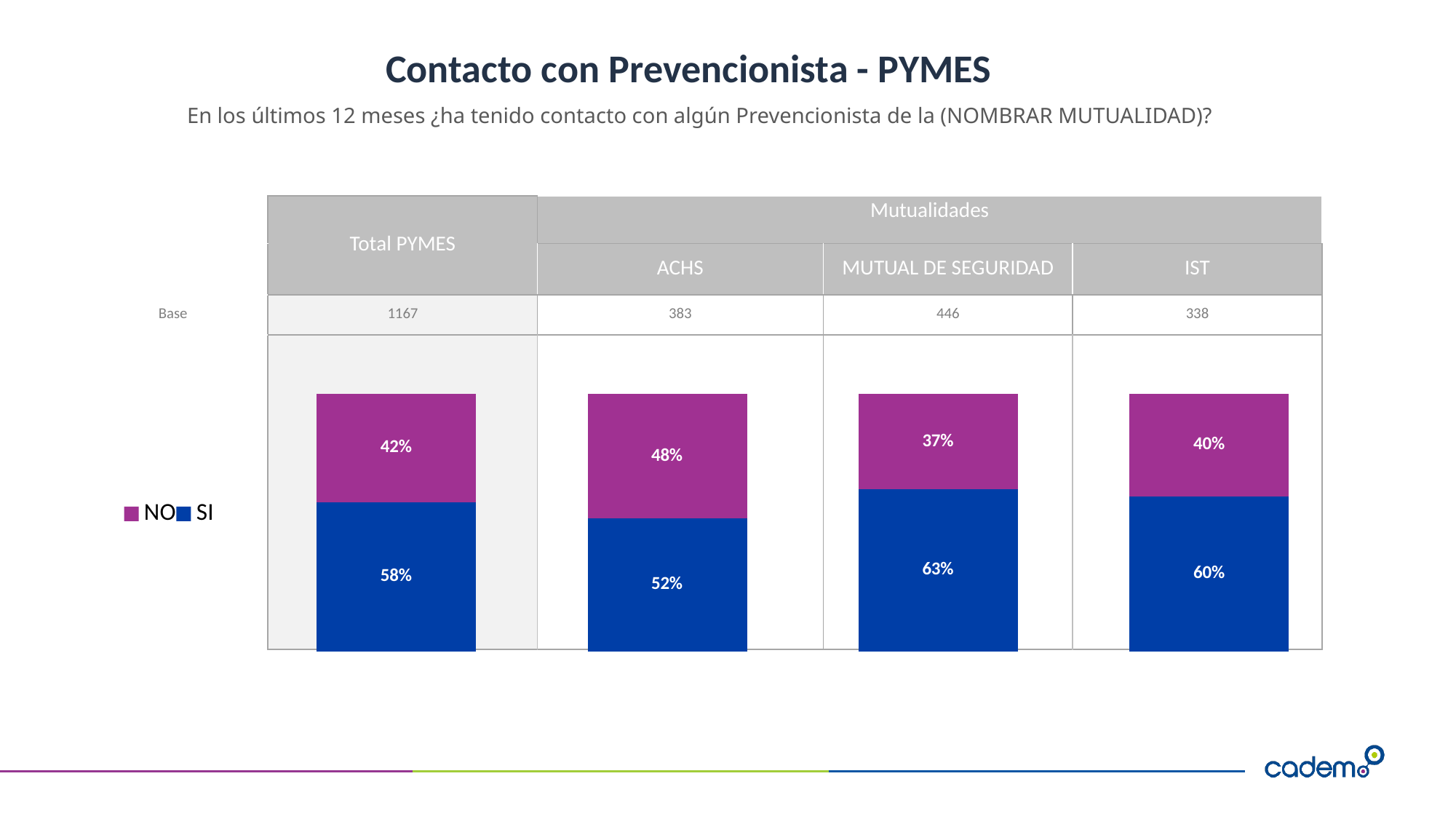
Which category has the lowest SI value? ACHS What is the SI value for MUTUAL DE SEGURIDAD? 63% How many categories are shown in the chart? 4 What is the difference between the SI values for MUTUAL DE SEGURIDAD and ACHS? 11% What kind of chart is shown on the slide? Stacked bar chart Which is larger, the NO value for ACHS or the NO value for IST? ACHS How many series does the legend list? 2 What is the SI value for Total PYMES? 58% What is the NO value for ACHS? 48% What is the total of the stacked bar for IST? 100% What is the NO value for IST? 40% Which category has the highest SI value? MUTUAL DE SEGURIDAD